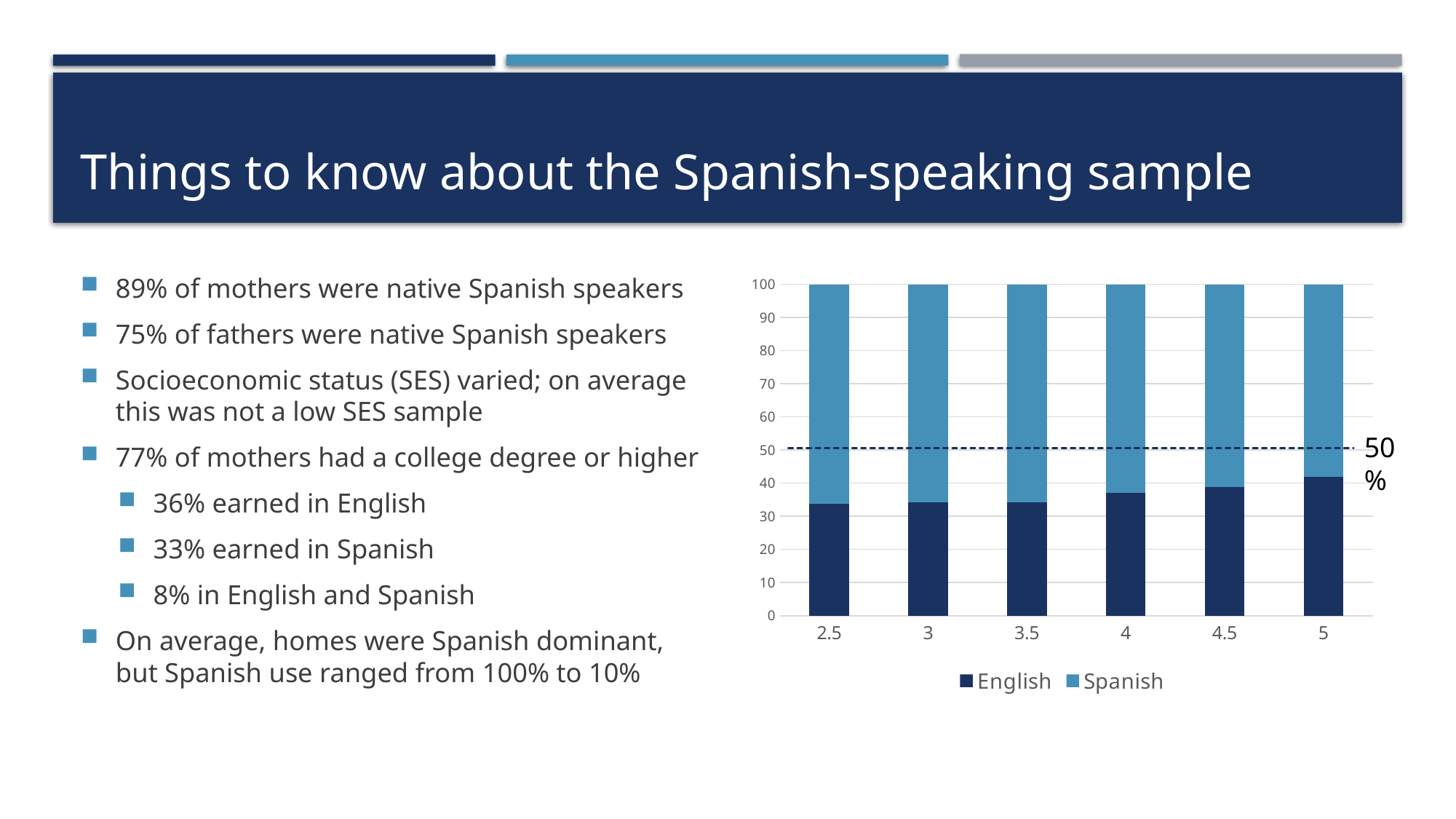
Does the English series rise or fall as you move from 2.5 to 5 along the x axis? rise Is the Spanish portion of the bar at category 2.5 greater or less than 60? greater How many series does the chart's legend list? 2 Is the English value at category 2.5 greater or less than 40? less What value is labelled on the dashed horizontal line across the chart? 50% Is the English value at category 5 greater or less than 50? less What kind of chart is shown on the slide? Stacked bar chart How many categories are shown on the x axis of the chart? 6 Which is larger, the English value at category 5 or the English value at category 2.5? Category 5 At which category is the English value highest? 5 What are the two series named in the chart's legend? English and Spanish